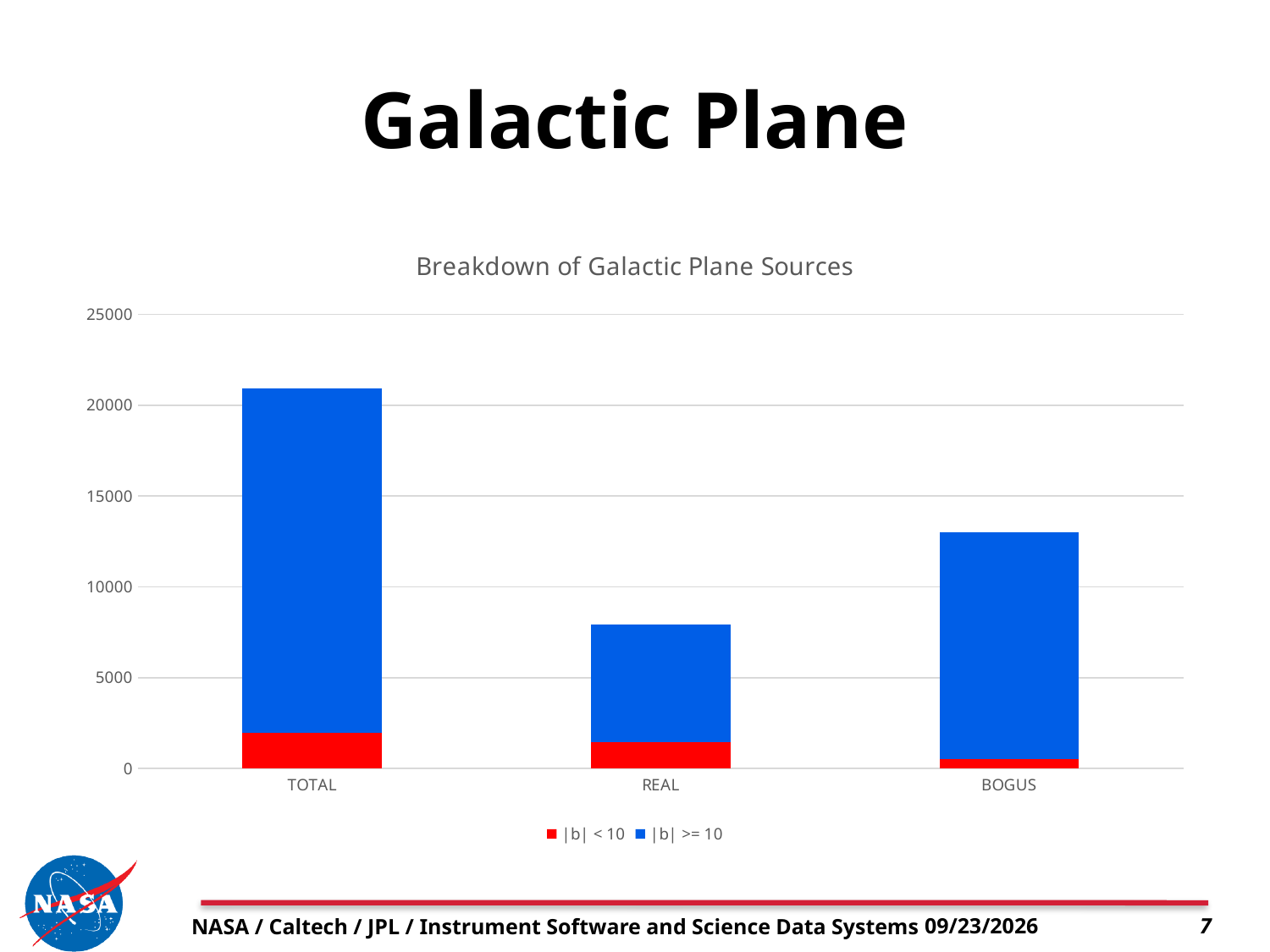
Is the total height of the REAL bar greater or less than 10000? less Which is larger, the stacked bar for BOGUS or the stacked bar for REAL? BOGUS Which category has the shortest stacked bar? REAL What kind of chart is shown on the slide? stacked bar chart How many categories are shown on the x axis of the chart? 3 Is the total height of the BOGUS bar greater or less than 15000? less What is the title of the chart? Breakdown of Galactic Plane Sources Which series is shown in red in the chart? |b| < 10 Is the |b| < 10 portion of the TOTAL bar greater or less than 5000? less How many series does the chart's legend list? 2 Which category has the tallest stacked bar? TOTAL